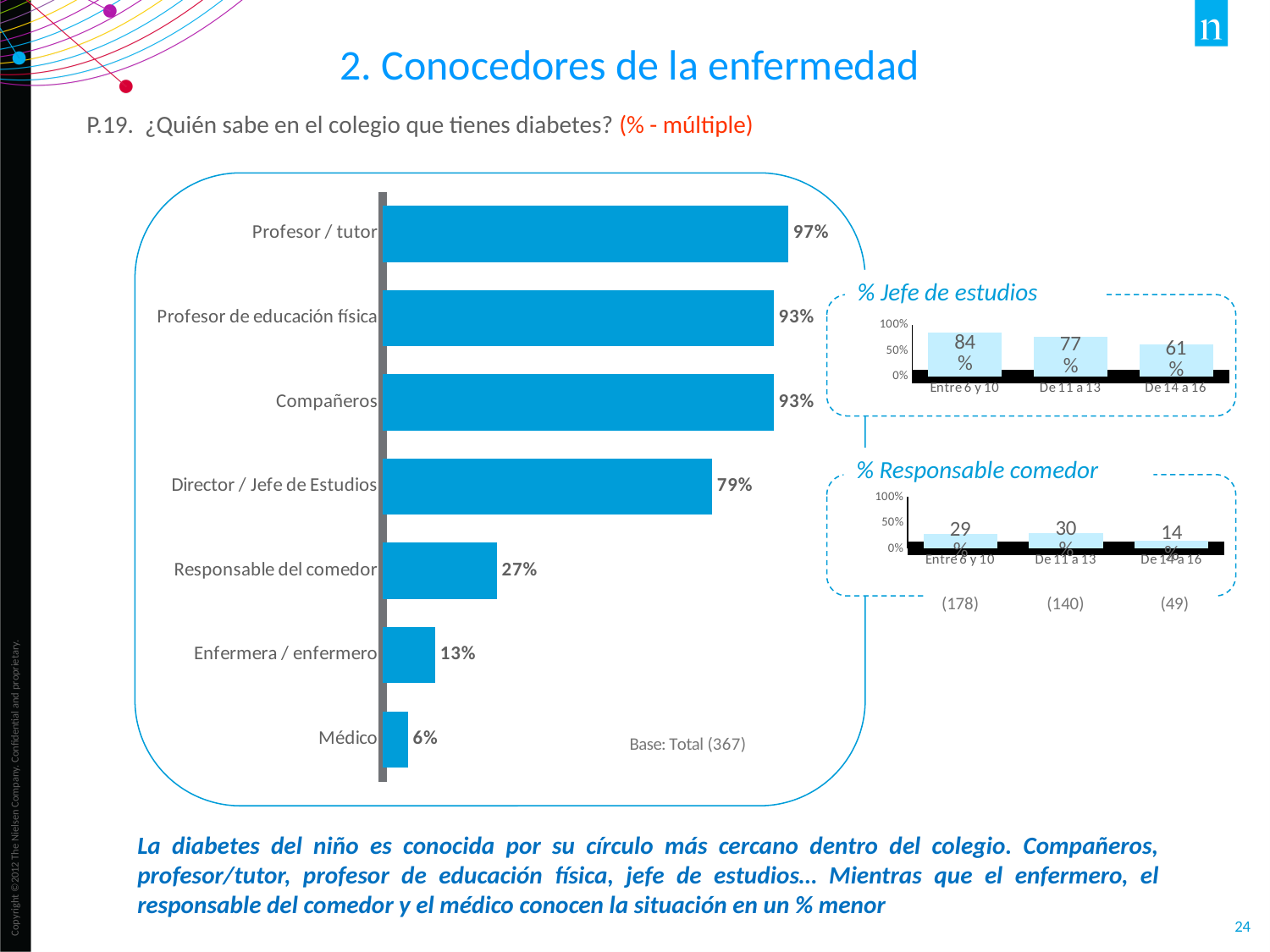
In the main bar chart, which category has the highest value? Profesor / tutor In the main bar chart, how many categories are shown? 7 In the '% Responsable comedor' chart, what is the value for De 11 a 13? 30% In the main bar chart, which category has the lowest value? Médico In the main bar chart, what is the difference between Director / Jefe de Estudios and Enfermera / enfermero? 66% In the '% Jefe de estudios' chart, is the value for Entre 6 y 10 greater or less than 50%? greater In the '% Jefe de estudios' chart, what is the value for De 14 a 16? 61% What type of chart is the main chart on the slide? Bar chart In the main bar chart, what percentage is shown for Responsable del comedor? 27% In the main bar chart, what percentage is shown for Profesor / tutor? 97% In the '% Responsable comedor' chart, which age group has the lowest value? De 14 a 16 In the '% Jefe de estudios' chart, do the values rise or fall from Entre 6 y 10 to De 14 a 16? Fall